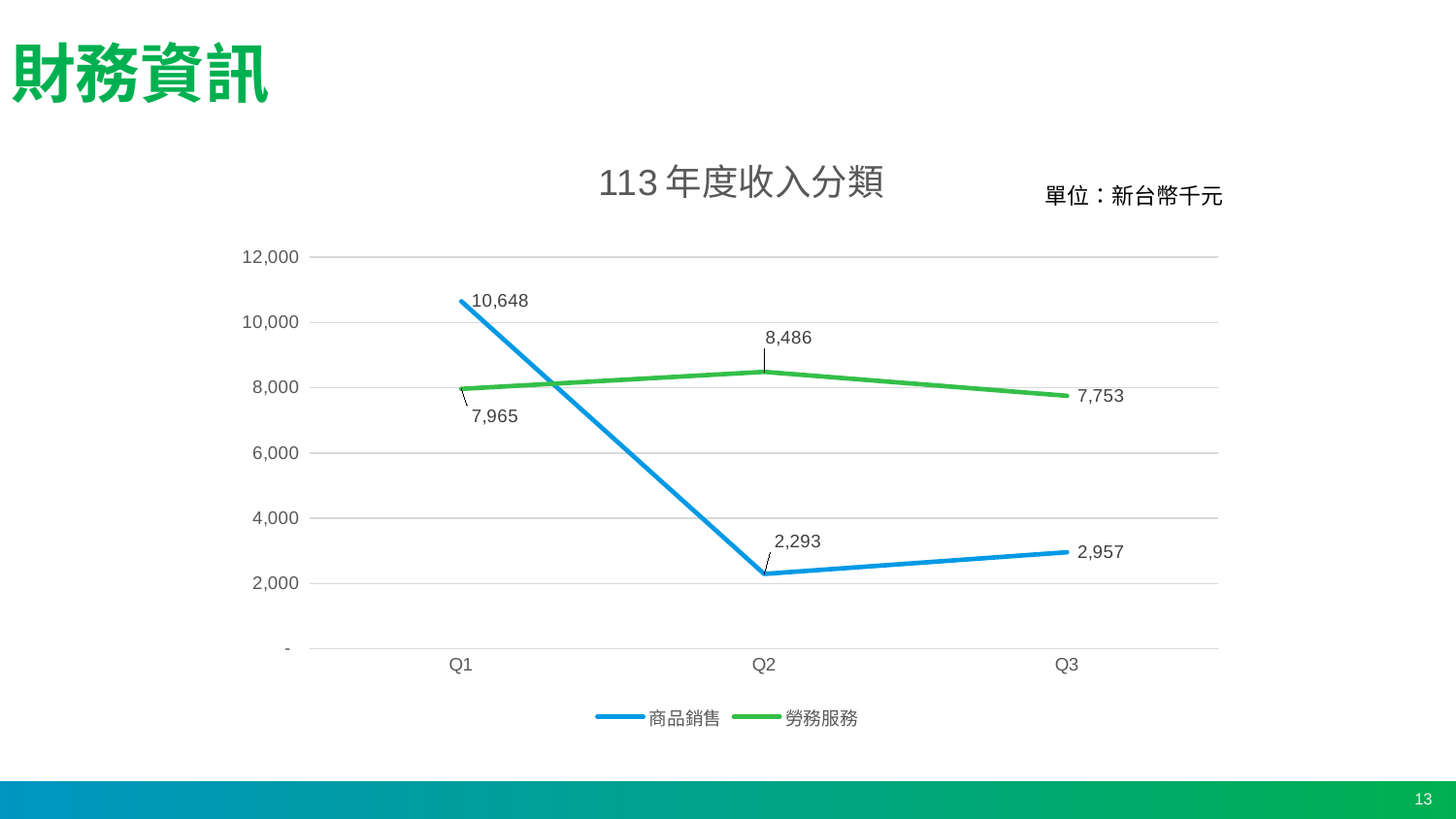
What is the value for 勞務服務 in Q3? 7,753 What is the value for 勞務服務 in Q2? 8,486 What kind of chart is shown on the slide? Line chart In which quarter is 商品銷售 lowest? Q2 How many series does the legend list? 2 What is the difference between 商品銷售 and 勞務服務 in Q1? 2,683 In which quarter is 勞務服務 highest? Q2 What is the title of the chart? 113 年度收入分類 What is the value for 商品銷售 in Q3? 2,957 Which series has the larger value in Q3, 商品銷售 or 勞務服務? 勞務服務 What is the value for 商品銷售 in Q1? 10,648 How many quarters are shown on the x axis? 3